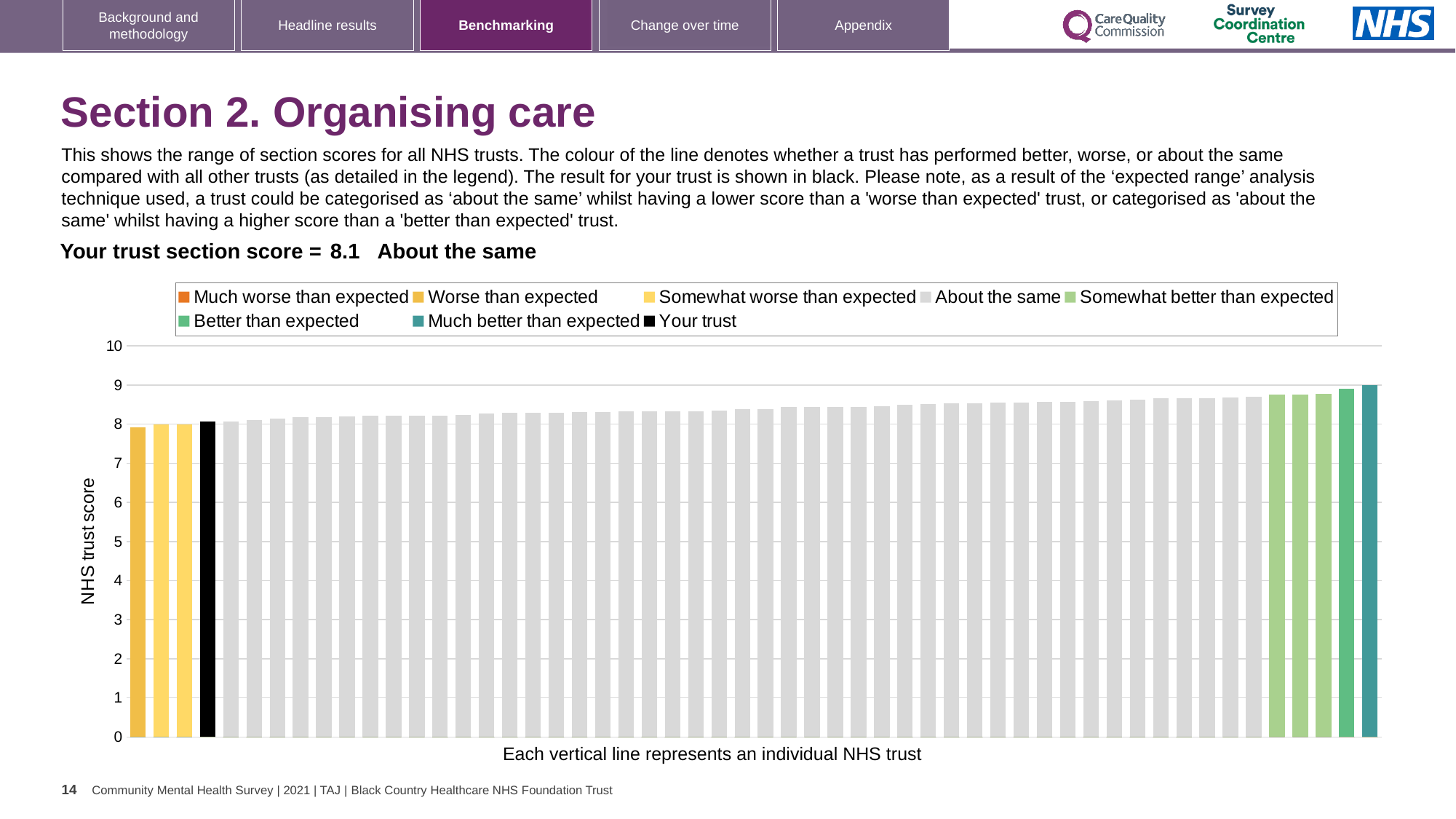
Do the bar values rise or fall from left to right along the x axis? rise What kind of chart is shown on the slide? bar chart Which legend category does the tallest bar belong to? Much better than expected How is your trust categorised compared with other trusts? About the same Is the tallest bar greater or less than 8? greater How many entries does the legend list? 8 Is the tallest bar greater or less than 10? less What is the label on the y axis? NHS trust score What colour is the bar for your trust? black What is the section score for your trust? 8.1 Is the value for your trust greater or less than 5? greater